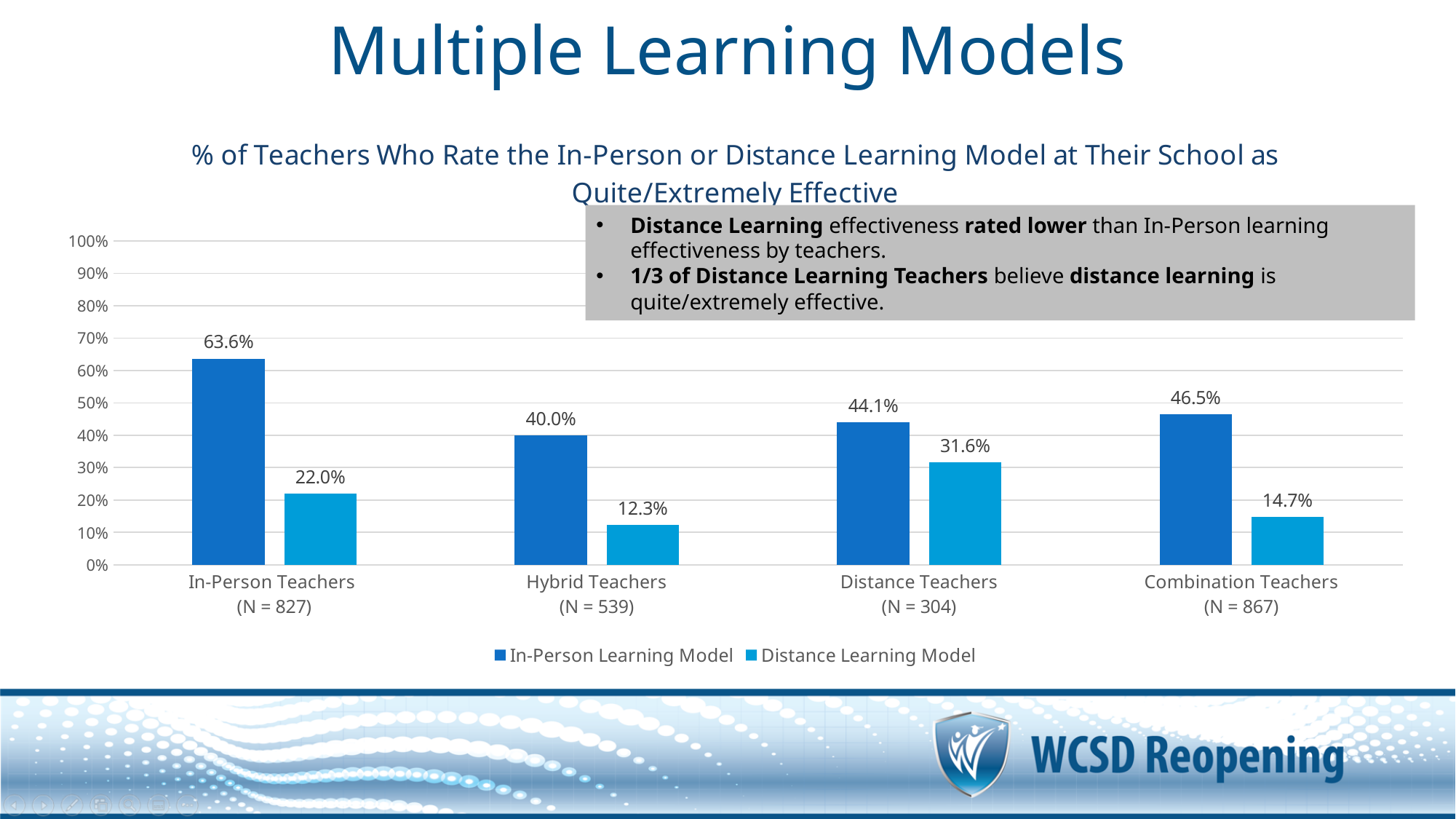
Is the In-Person Learning Model value for Hybrid Teachers greater or less than 50%? less What is the sample size (N) shown for Distance Teachers? 304 What is the value for the Distance Learning Model among Distance Teachers? 31.6% Which is larger for Distance Teachers: the In-Person Learning Model value or the Distance Learning Model value? In-Person Learning Model Which teacher group has the highest value for the In-Person Learning Model? In-Person Teachers What kind of chart is shown on the slide? Bar chart How many series does the legend list? 2 Which teacher group has the lowest value for the Distance Learning Model? Hybrid Teachers How many teacher groups are shown on the x axis? 4 What is the difference between the In-Person Learning Model and Distance Learning Model values for Combination Teachers? 31.8% What is the value for the Distance Learning Model among Hybrid Teachers? 12.3% What percentage of In-Person Teachers rate the In-Person Learning Model as quite/extremely effective? 63.6%